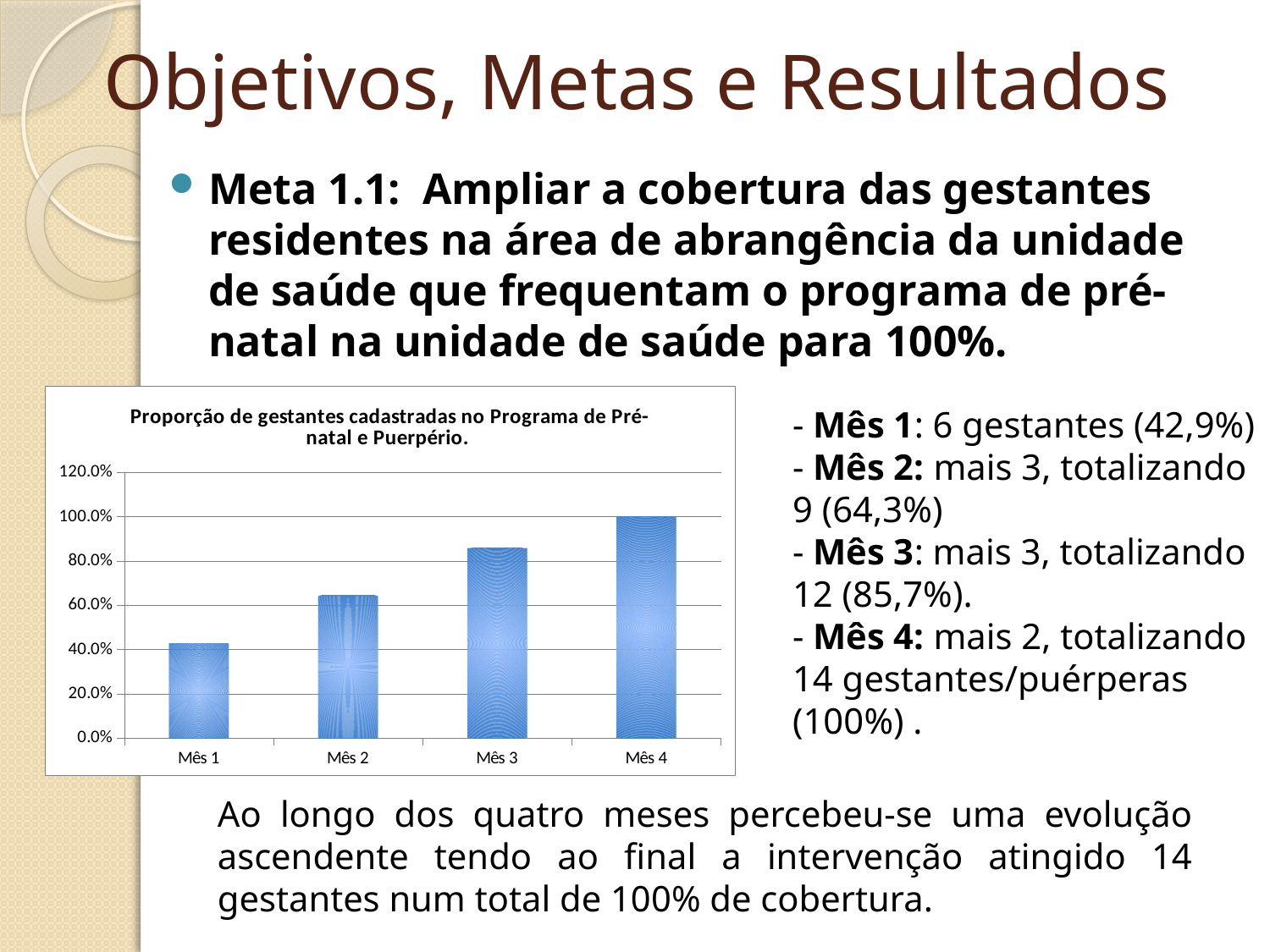
What is the value for Mês 4 on the chart? 100.0% Is the value for Mês 2 greater or less than 40.0%? greater Which month has the highest bar on the chart? Mês 4 Which month has the lowest bar on the chart? Mês 1 What is the title of the chart? Proporção de gestantes cadastradas no Programa de Pré-natal e Puerpério. Is the value for Mês 3 greater or less than 80.0%? greater What is the highest tick shown on the vertical axis of the chart? 120.0% Is the value for Mês 1 greater or less than 60.0%? less What kind of chart is shown on the slide? bar chart Do the values rise or fall from Mês 1 to Mês 4? rise How many categories (months) are plotted on the chart? 4 Which is larger, the value for Mês 2 or the value for Mês 3? Mês 3